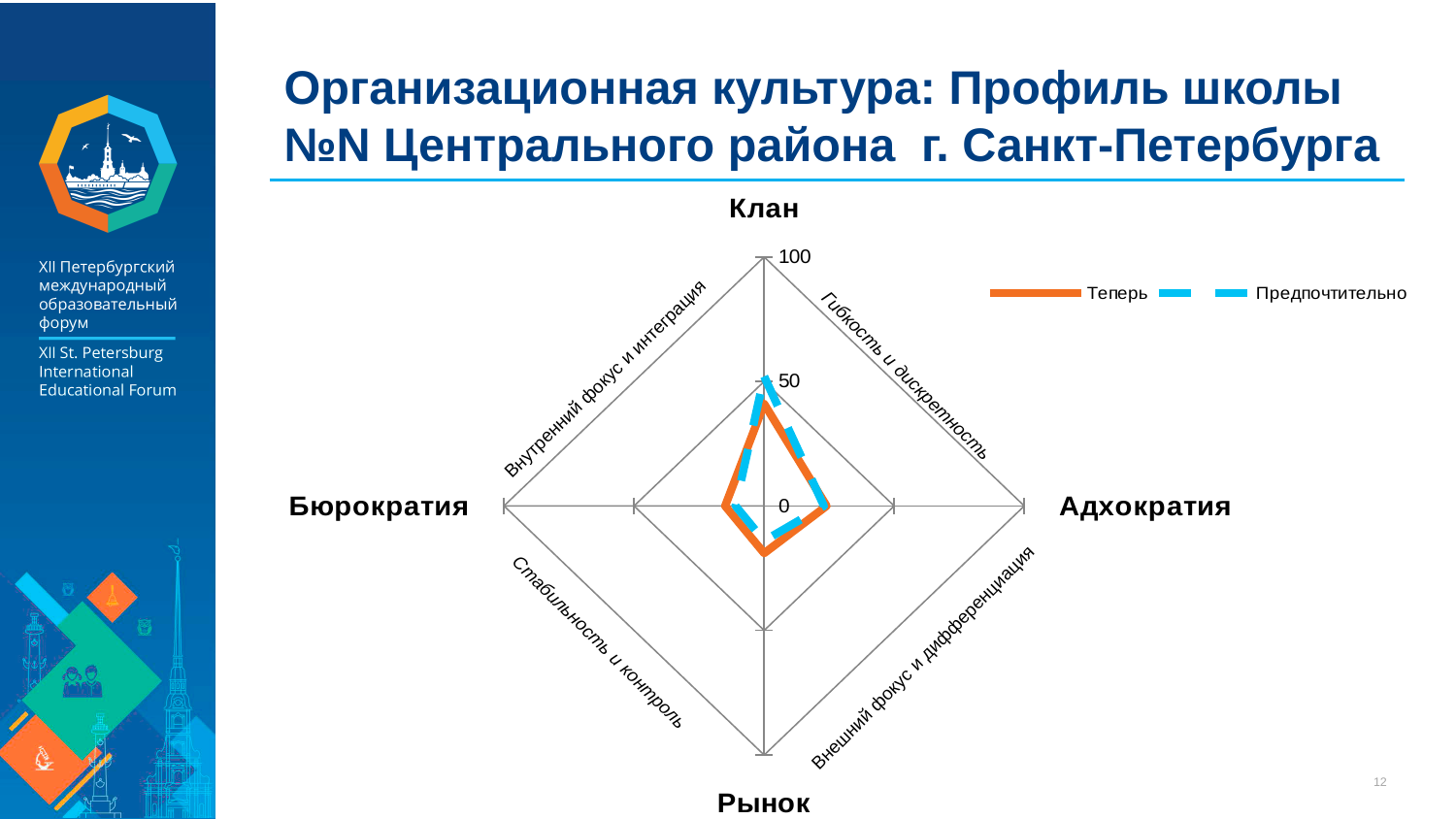
Which category has the highest value for the Предпочтительно series? Клан How many axes (categories) does the radar chart have? 4 For the Теперь series, which is larger: the value for Клан or the value for Адхократия? Клан Is the value for Рынок in the Предпочтительно series greater or less than 50? less What kind of chart is shown on the slide? Radar chart What are the two series named in the legend? Теперь and Предпочтительно How many series does the legend list? 2 Is the value for Адхократия in the Теперь series greater or less than 50? less Which series is drawn with a dashed line? Предпочтительно For the Предпочтительно series, which is larger: the value for Клан or the value for Бюрократия? Клан Is the value for Бюрократия in the Теперь series greater or less than 50? less Which category has the highest value for the Теперь series? Клан